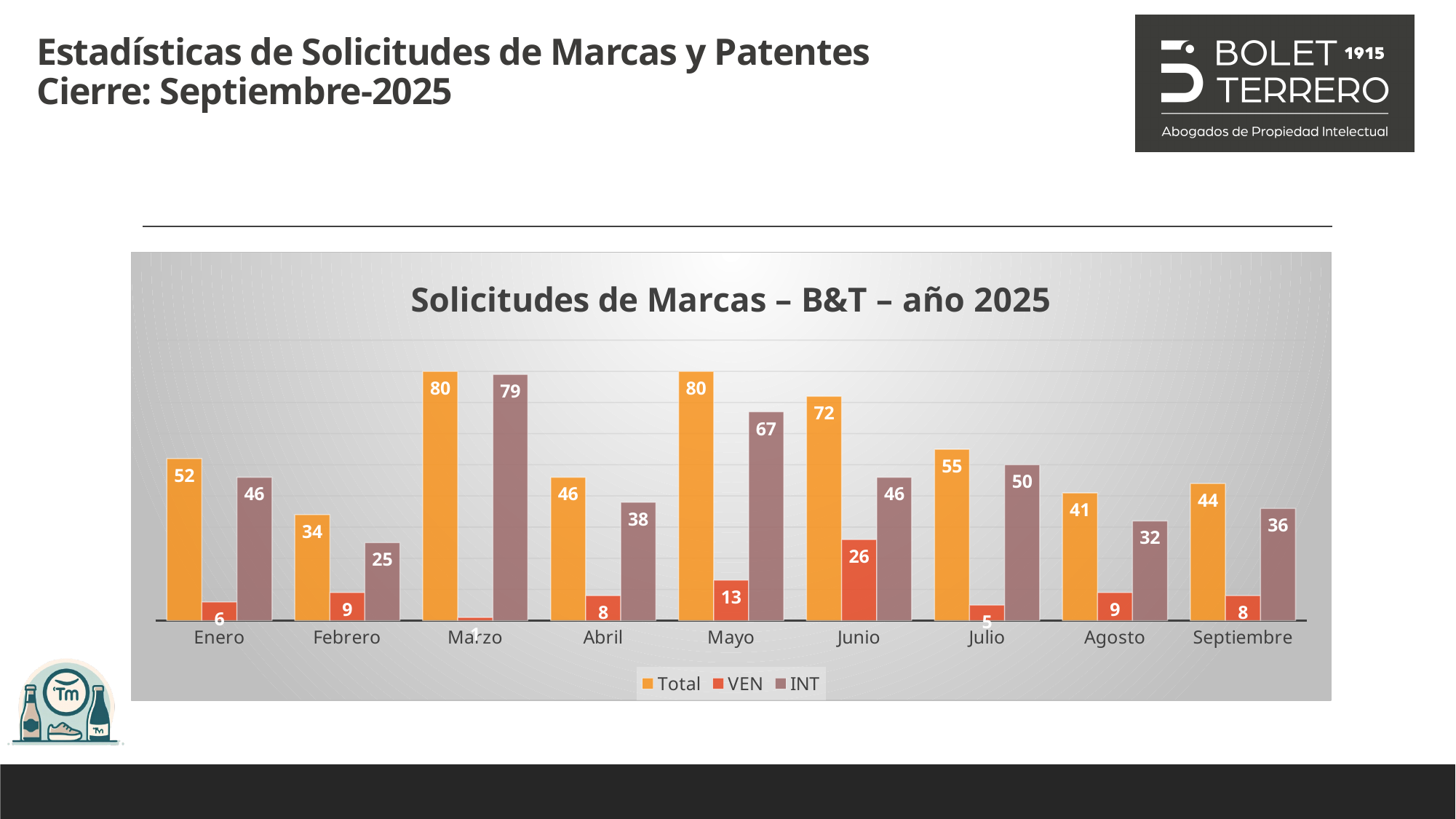
Which month has the lowest Total value? Febrero What is the VEN value for Septiembre? 8 Which month has the highest INT value? Marzo How many months are shown on the x axis? 9 What is the title of the chart? Solicitudes de Marcas – B&T – año 2025 Which month has the highest VEN value? Junio What is the Total value for Junio? 72 Which is larger, the INT value for Abril or the INT value for Agosto? Abril How many series does the legend list? 3 What is the difference between the Total and INT values for Julio? 5 What is the INT value for Mayo? 67 What kind of chart is shown on the slide? Bar chart